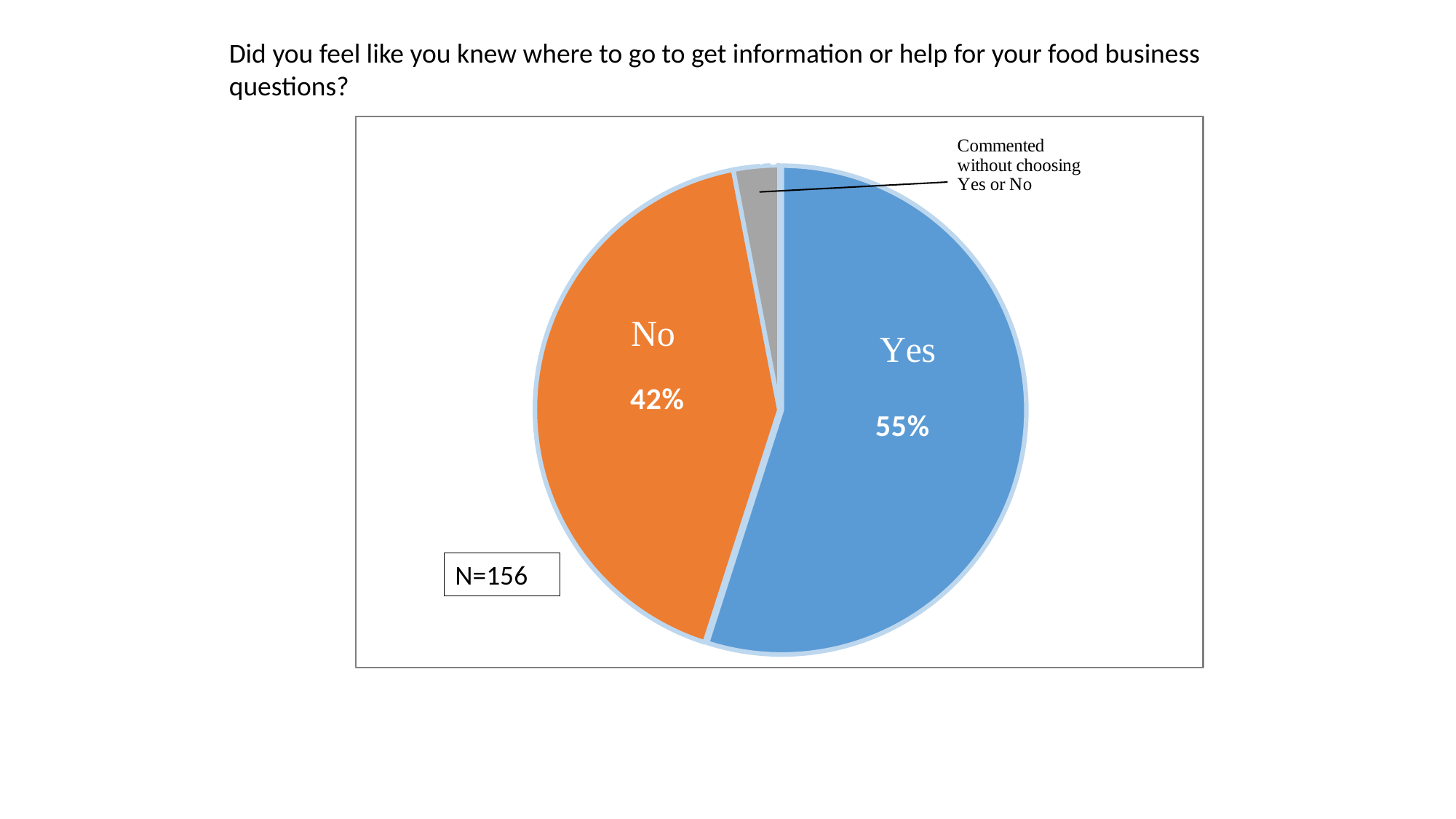
Which is larger, the Yes slice or the No slice? Yes What is the difference in percentage points between the Yes and No slices? 13 What kind of chart is shown on the slide? pie chart Is the share for No greater or less than 50%? less How many slices does the pie chart have? 3 What share of respondents answered Yes? 55% Which slice of the pie is the smallest? Commented without choosing Yes or No What colour is the Yes slice? blue Which slice of the pie is the largest? Yes What is the sample size (N) shown on the chart? N=156 What share of respondents answered No? 42%